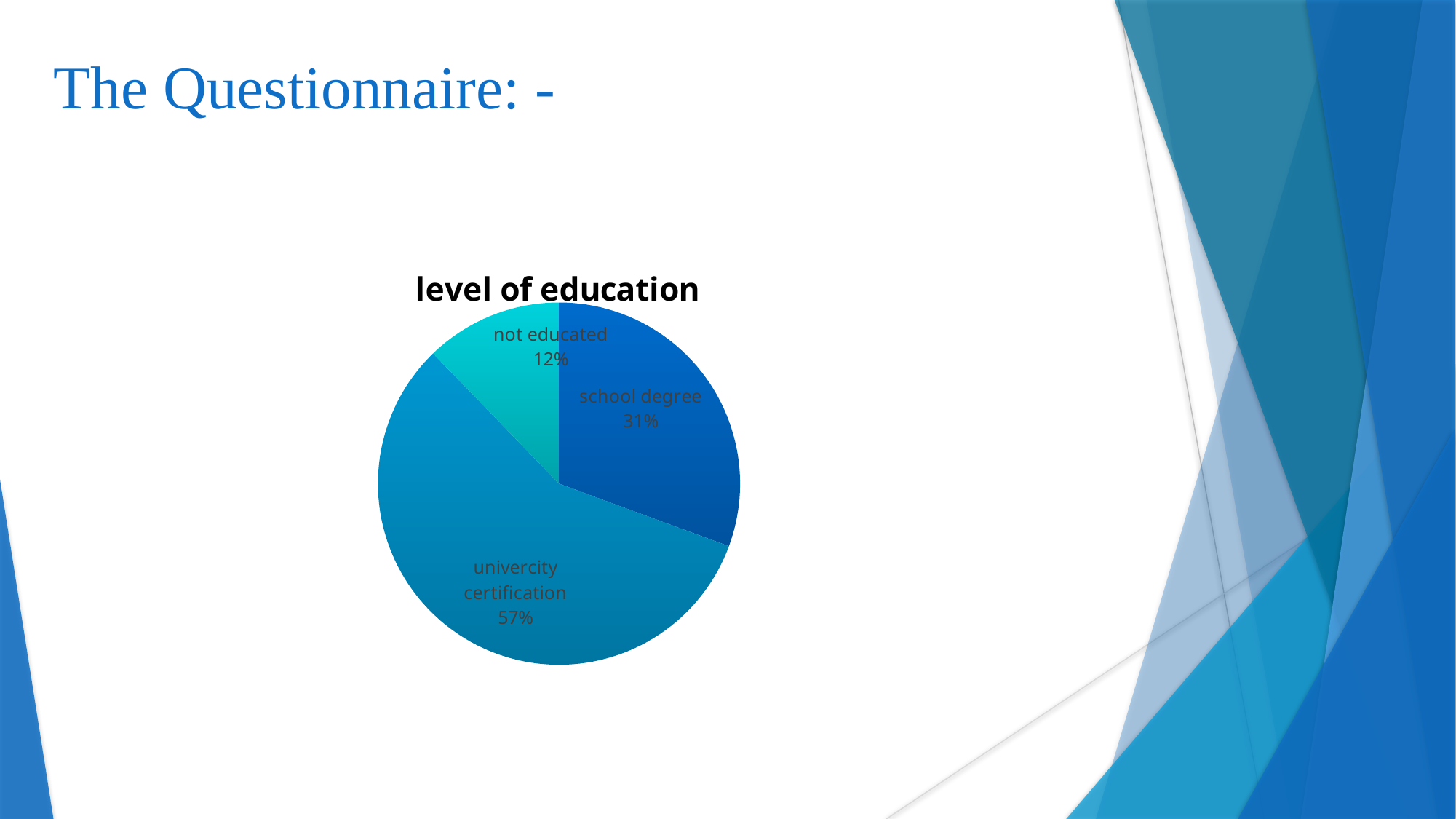
What is the difference in percentage points between 'school degree' and 'not educated'? 19 What share of the pie does 'school degree' represent? 31% What is the difference in percentage points between 'univercity certification' and 'school degree'? 26 What share of the pie does 'univercity certification' represent? 57% What kind of chart is shown on the slide? pie chart Which is larger, the share for 'school degree' or the share for 'not educated'? school degree Is the share for 'univercity certification' greater or less than 50%? greater How many categories are shown in the pie chart? 3 Which category has the smallest slice of the pie? not educated Which category has the largest slice of the pie? univercity certification What share of the pie does 'not educated' represent? 12% What is the title of the chart? level of education